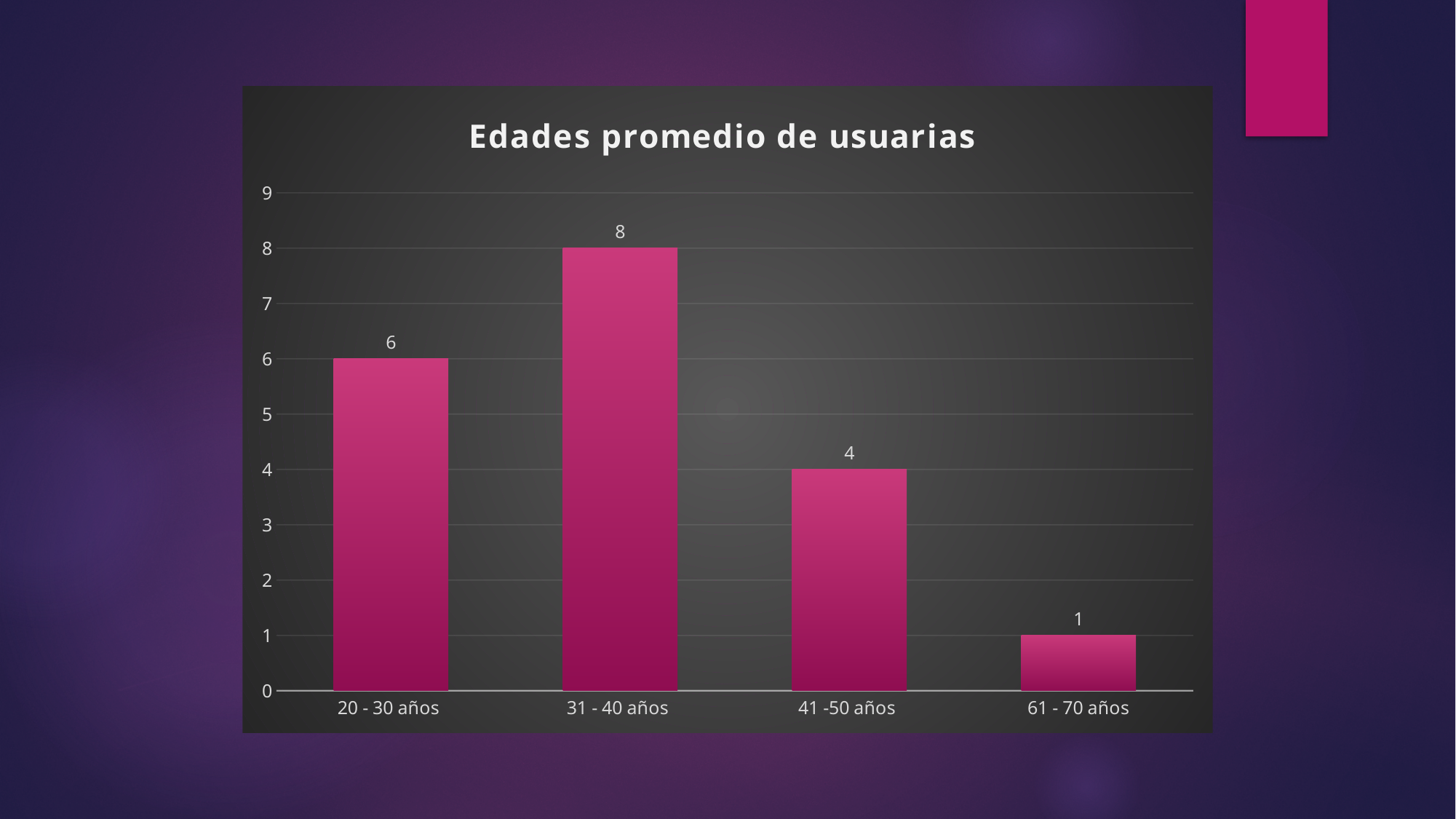
How many age groups are shown on the chart? 4 Which age group has the lowest value? 61 - 70 años What is the value for 20 - 30 años? 6 What is the value for 41 -50 años? 4 Which age group has the highest value? 31 - 40 años What is the title of the chart? Edades promedio de usuarias What is the difference between the values for 31 - 40 años and 41 -50 años? 4 Which is larger, the value for 20 - 30 años or the value for 41 -50 años? 20 - 30 años What is the value for 61 - 70 años? 1 What is the value for 31 - 40 años? 8 Do the values rise or fall from 31 - 40 años to 61 - 70 años? Fall What kind of chart is shown on the slide? Bar chart